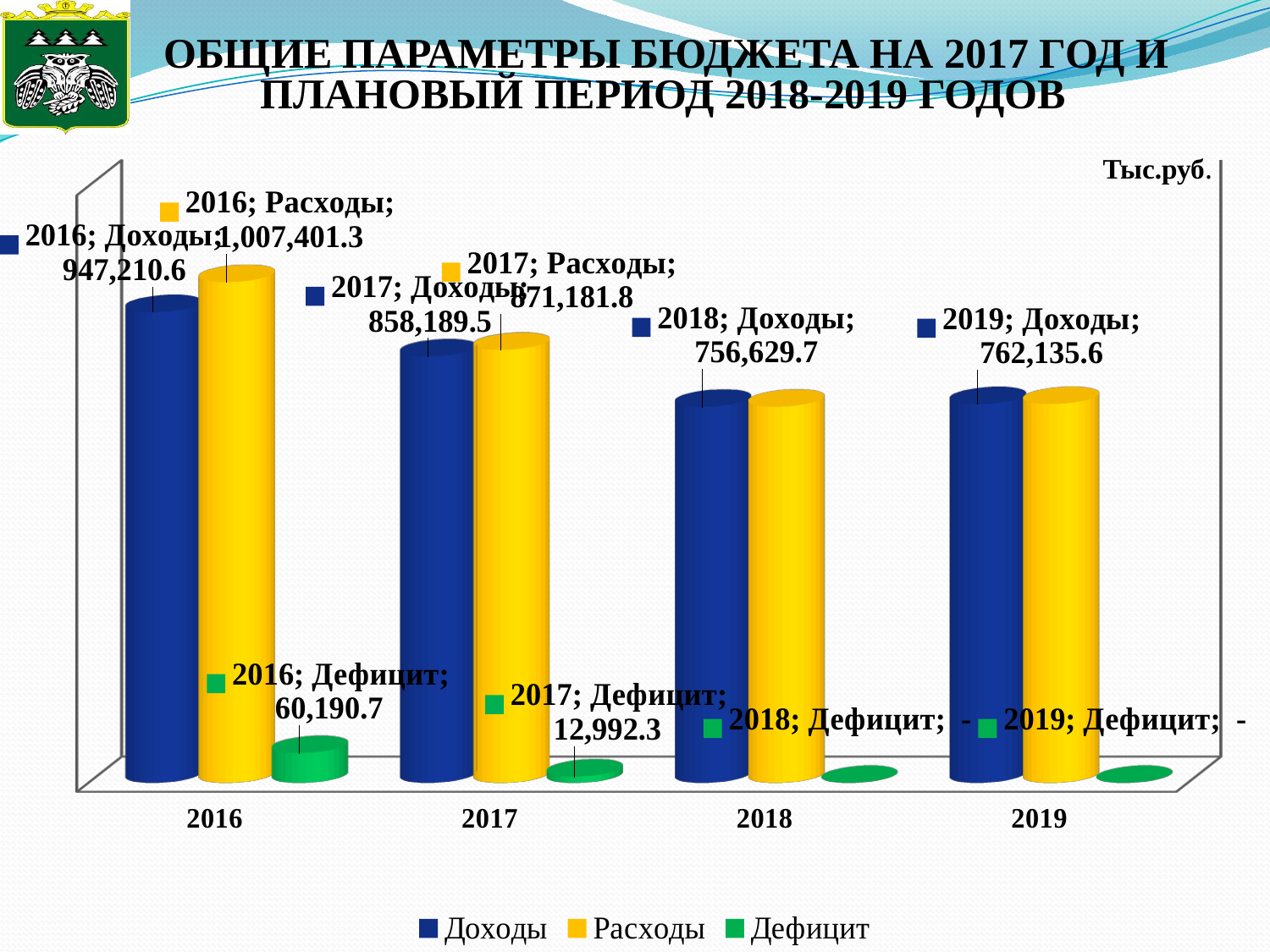
What is the value of Дефицит for 2016? 60,190.7 What is the value of Расходы for 2017? 871,181.8 What is the value of Доходы for 2016? 947,210.6 Which year has the highest Доходы value? 2016 Which is larger for 2017: Доходы or Расходы? Расходы How many years are shown on the x axis? 4 What is the value of Доходы for 2019? 762,135.6 How many series does the legend list? 3 What unit is indicated for the chart values? Тыс.руб. Which year has the lowest Доходы value? 2018 What is the difference between Расходы and Доходы for 2016? 60,190.7 What kind of chart is shown on the slide? Bar chart